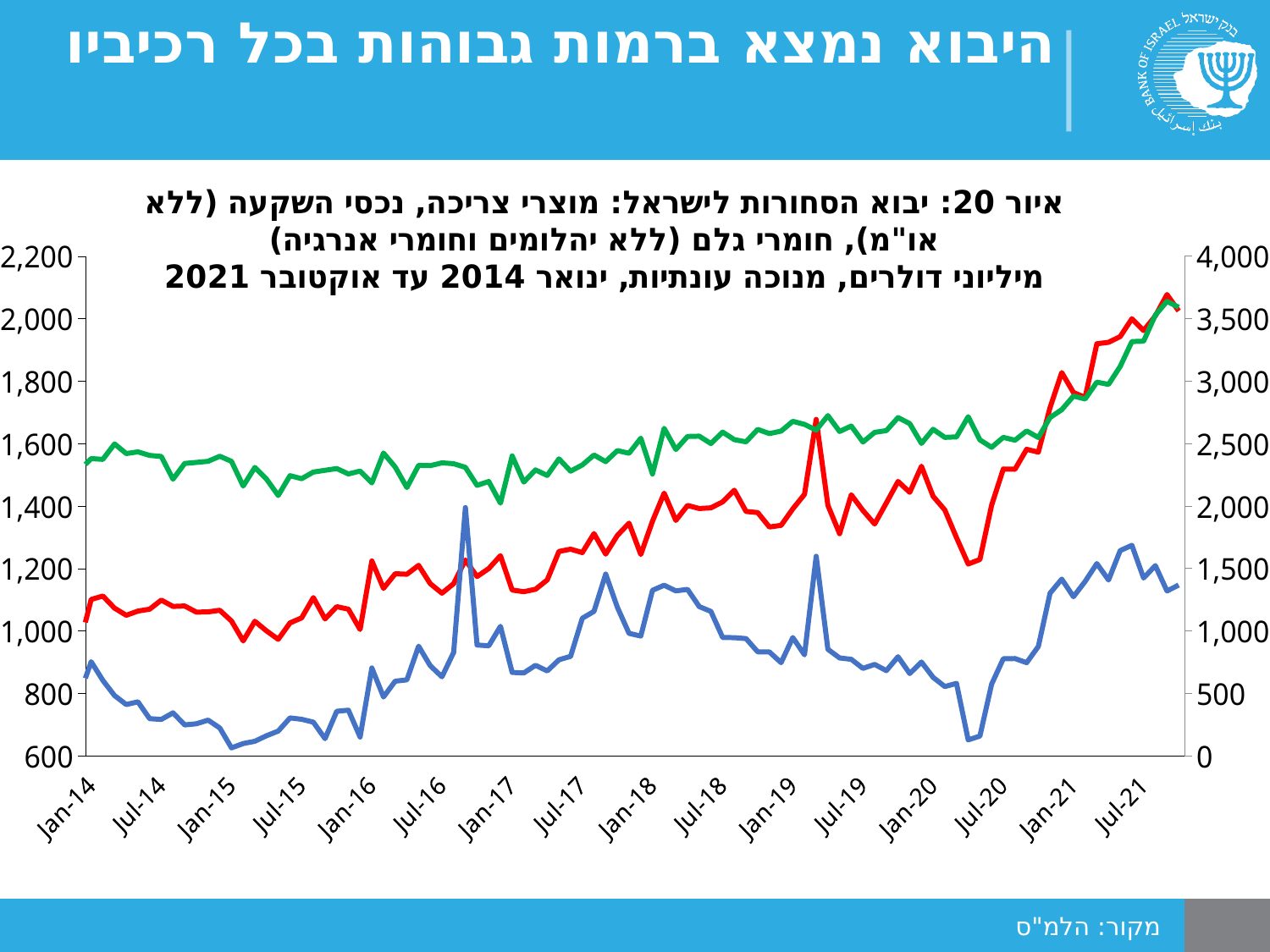
Which line is the lowest on the chart at Jan-14: the red, green or blue line? blue What kind of chart is shown on the slide? line chart Does the blue line rise or fall between Jan-14 and Jan-15? fall What is the first date label on the x axis of the chart? Jan-14 What is the last date label shown on the x axis of the chart? Jul-21 Which line is the lowest on the chart at the end of the period (after Jul-21)? blue Does the red line rise or fall between Jul-20 and Jul-21? rise What is the lowest tick value on the left y axis? 600 What is the highest tick value on the right y axis? 4,000 How many lines (series) are plotted on the chart? 3 What is the highest tick value on the left y axis? 2,200 Which line is the highest on the chart at Jan-14: the red, green or blue line? green